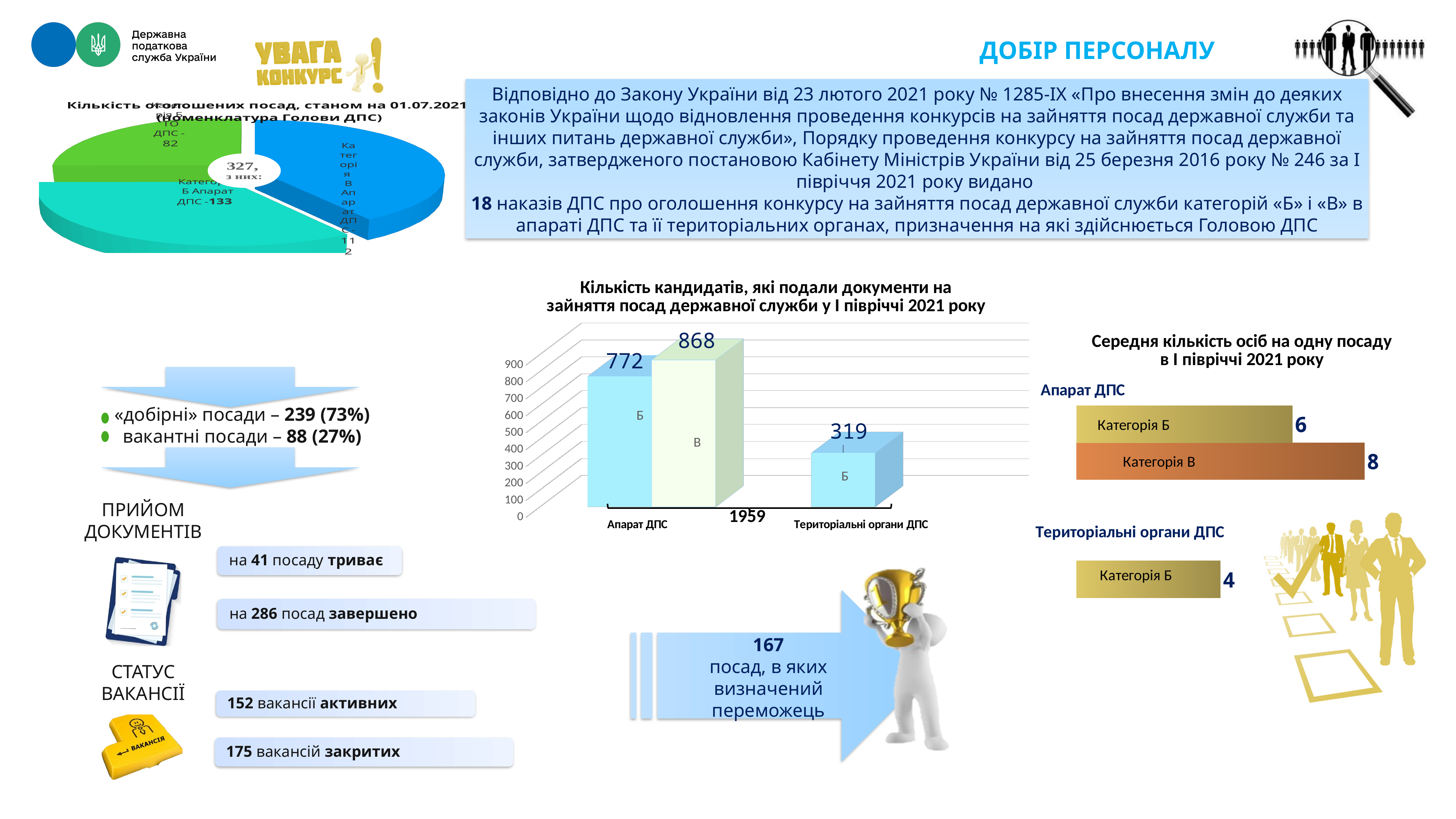
In the pie chart at the top left, what total is shown in the centre? 327 In the bar chart 'Кількість кандидатів, які подали документи...', which bar is the highest? В (Апарат ДПС) In the bar chart 'Кількість кандидатів, які подали документи...', which bar is the lowest? Б (Територіальні органи ДПС) In the pie chart at the top left, what value is shown for Категорія Б Апарат ДПС? 133 In the bar chart 'Кількість кандидатів, які подали документи...', what total is printed under the Апарат ДПС bars? 1959 In the 'Середня кількість осіб на одну посаду в І півріччі 2021 року' chart, what is the value for Категорія В in Апарат ДПС? 8 In the bar chart 'Кількість кандидатів, які подали документи...', what is the value for category В in Апарат ДПС? 868 In the bar chart 'Кількість кандидатів, які подали документи...', what is the value for Територіальні органи ДПС? 319 In the bar chart 'Кількість кандидатів, які подали документи на зайняття посад державної служби у І півріччі 2021 року', what is the value for category Б in Апарат ДПС? 772 What kind of chart is 'Кількість кандидатів, які подали документи на зайняття посад державної служби у І півріччі 2021 року'? bar chart In the bar chart 'Кількість кандидатів, які подали документи...', what is the difference between the В bar and the Б bar for Апарат ДПС? 96 In the bar chart 'Кількість кандидатів, які подали документи...', how many bars are plotted? 3